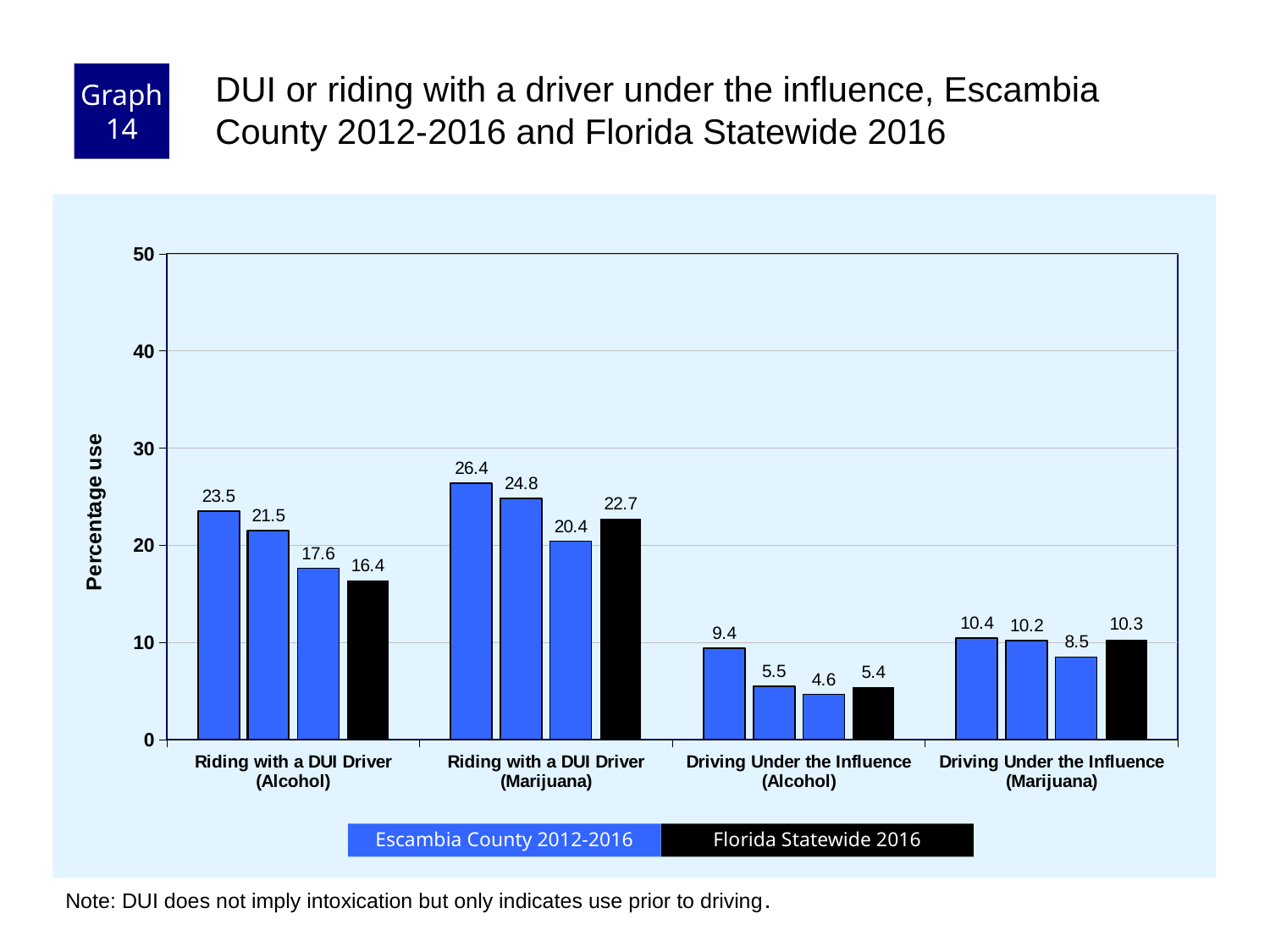
What is the value of the tallest bar in the Riding with a DUI Driver (Marijuana) group? 26.4 Within the Riding with a DUI Driver (Alcohol) group, do the Escambia County bars rise or fall from left to right? fall How many series does the legend list? 2 What kind of chart is shown on the slide? bar chart How many categories are shown on the x axis? 4 What is the Florida Statewide 2016 value for Driving Under the Influence (Marijuana)? 10.3 Is the Florida Statewide 2016 value for Riding with a DUI Driver (Marijuana) greater or less than 20? greater Which category has the highest Florida Statewide 2016 value? Riding with a DUI Driver (Marijuana) Which category has the lowest Florida Statewide 2016 value? Driving Under the Influence (Alcohol) What is the Florida Statewide 2016 value for Riding with a DUI Driver (Alcohol)? 16.4 In the Riding with a DUI Driver (Marijuana) group, what is the difference between the first Escambia County bar (26.4) and the Florida Statewide 2016 bar? 3.7 Which is larger: the Florida Statewide 2016 value for Riding with a DUI Driver (Alcohol) or for Driving Under the Influence (Marijuana)? Riding with a DUI Driver (Alcohol)